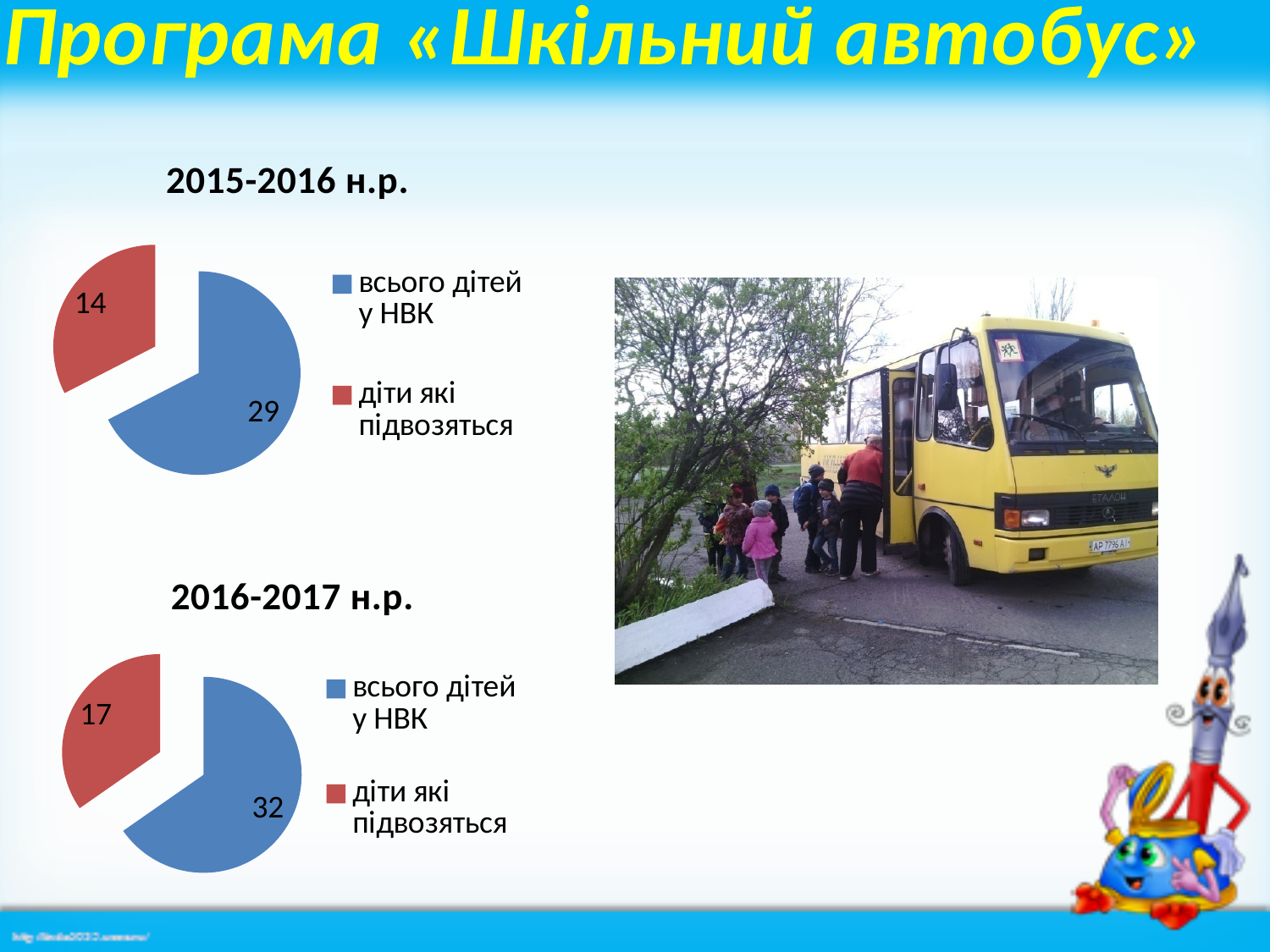
How many slices does the 2015-2016 н.р. pie chart have? 2 In the 2016-2017 н.р. chart, which category has the smallest slice? діти які підвозяться What type of chart is the 2016-2017 н.р. chart? pie chart In the 2016-2017 н.р. chart, what is the value for «діти які підвозяться»? 17 In the 2015-2016 н.р. chart, what is the value for «діти які підвозяться»? 14 Which is larger: «діти які підвозяться» in the 2015-2016 н.р. chart or in the 2016-2017 н.р. chart? 2016-2017 н.р. In the 2016-2017 н.р. chart, what colour is the slice for «діти які підвозяться»? red In the 2016-2017 н.р. chart, what is the difference between «всього дітей у НВК» and «діти які підвозяться»? 15 In the 2015-2016 н.р. chart, what is the value for «всього дітей у НВК»? 29 In the 2016-2017 н.р. chart, what is the value for «всього дітей у НВК»? 32 In the 2015-2016 н.р. chart, which category has the largest slice? всього дітей у НВК In the 2015-2016 н.р. chart, what is the difference between «всього дітей у НВК» and «діти які підвозяться»? 15